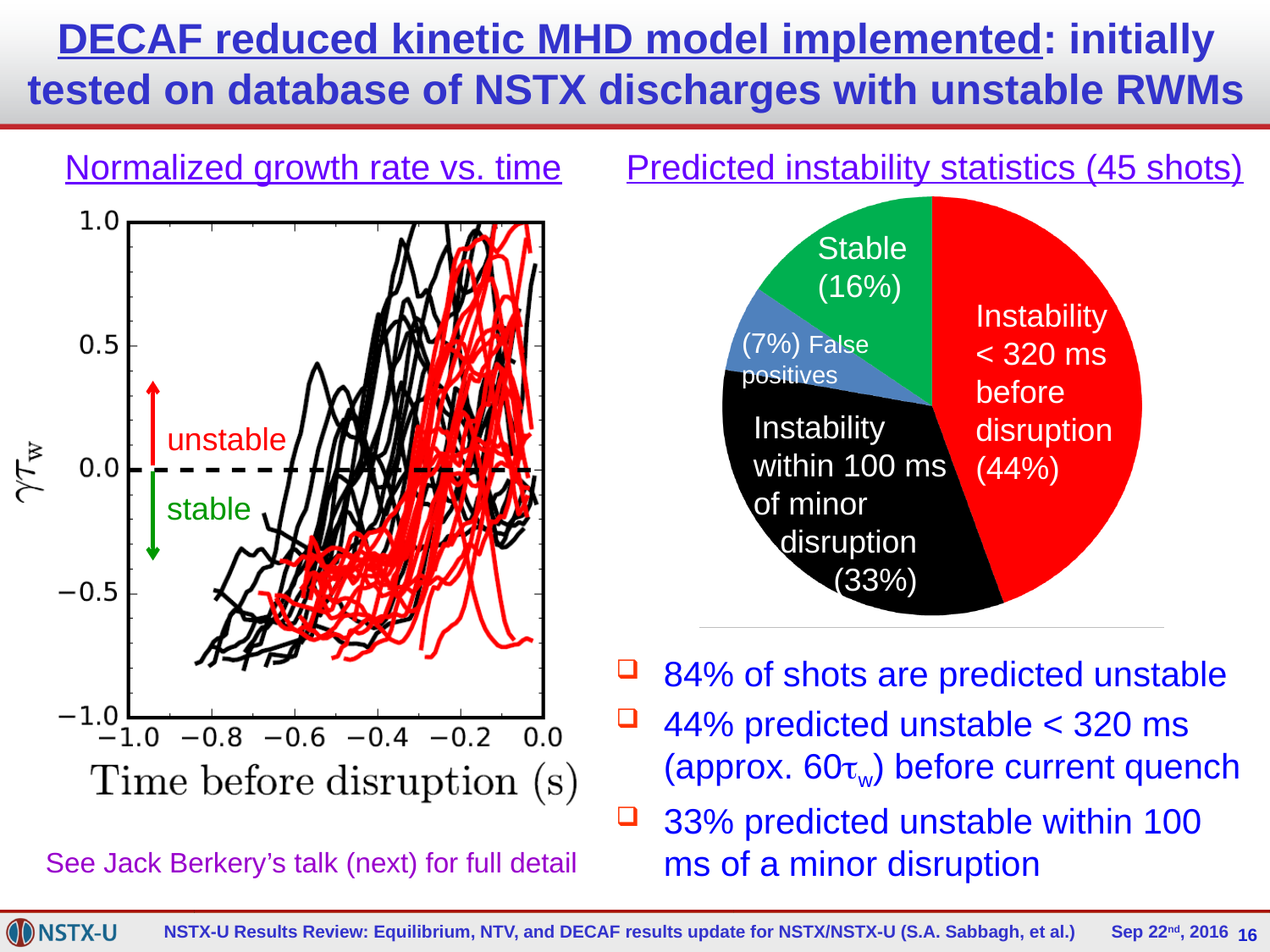
What kind of chart is the chart on the right of the slide, titled 'Predicted instability statistics (45 shots)'? Pie chart In the pie chart 'Predicted instability statistics (45 shots)', which slice is the largest? Instability < 320 ms before disruption (44%) In the chart 'Normalized growth rate vs. time', what is the label of the x axis? Time before disruption (s) What kind of chart is the chart on the left of the slide, titled 'Normalized growth rate vs. time'? Line chart In the pie chart 'Predicted instability statistics (45 shots)', what share of shots is labelled Stable? 16% In the pie chart 'Predicted instability statistics (45 shots)', what is the combined share of the two 'Instability' slices? 77% In the pie chart 'Predicted instability statistics (45 shots)', which slice is the smallest? False positives (7%) How many slices does the pie chart 'Predicted instability statistics (45 shots)' have? 4 In the pie chart 'Predicted instability statistics (45 shots)', what is the difference in percentage points between the 'Instability < 320 ms before disruption' slice and the 'Instability within 100 ms of minor disruption' slice? 11 percentage points In the pie chart 'Predicted instability statistics (45 shots)', which is larger: the Stable slice or the False positives slice? Stable In the pie chart 'Predicted instability statistics (45 shots)', what share of shots is labelled False positives? 7% In the chart 'Normalized growth rate vs. time', do the plotted growth rate curves generally rise or fall as time approaches 0.0 s before disruption? Rise